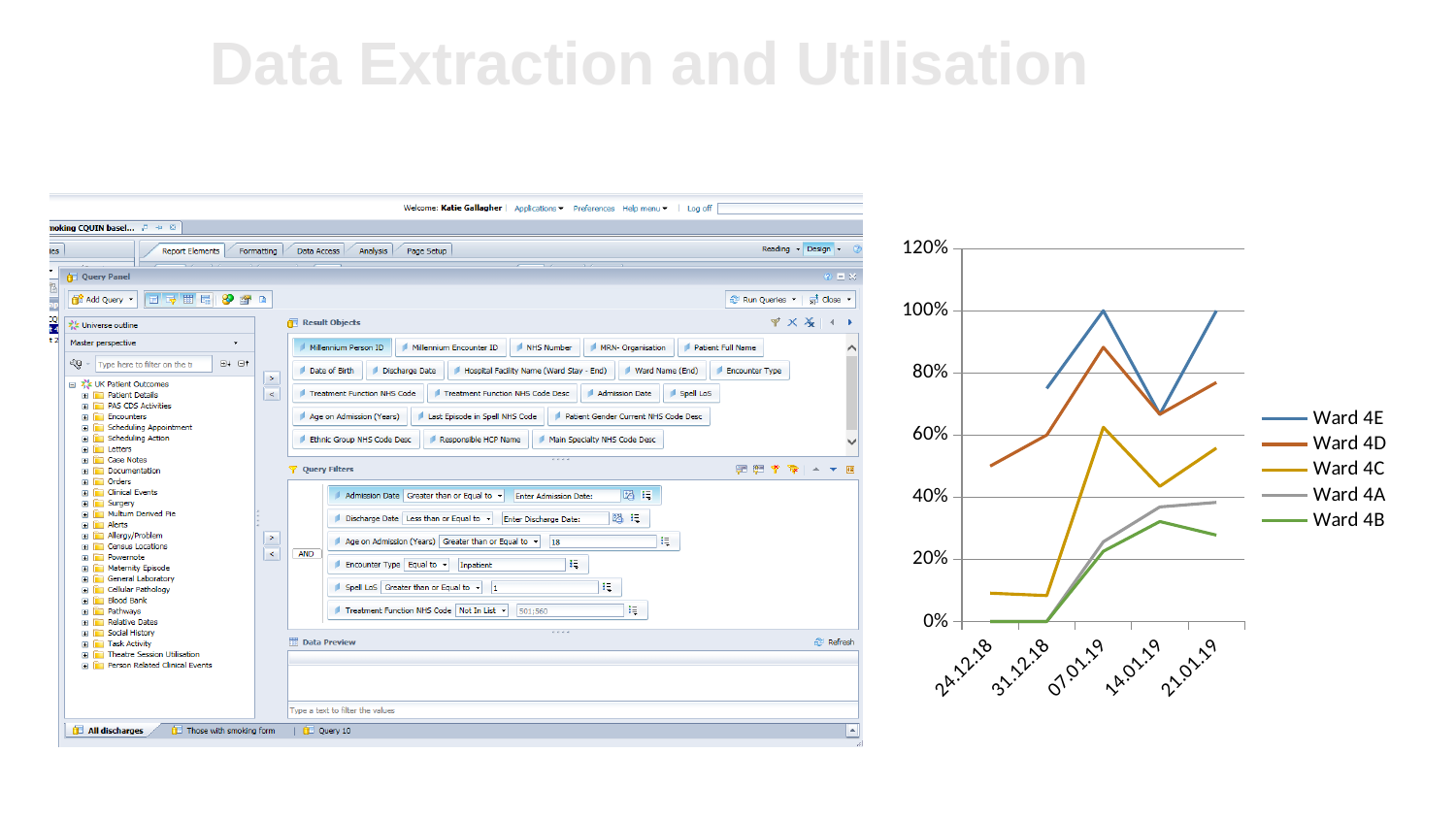
In the line chart, which ward has the lowest value on 21.01.19? Ward 4B In the line chart, what is the value for Ward 4A on 24.12.18? 0% What colour is the line for Ward 4B in the line chart? green How many series does the legend of the line chart list? 5 In the line chart, is the value for Ward 4C on 24.12.18 greater or less than 20%? less In the line chart, what is the value for Ward 4E on 07.01.19? 100% In the line chart, which ward has the highest value on 21.01.19? Ward 4E What kind of chart is shown on the right of the slide? line chart In the line chart, which is larger on 14.01.19: Ward 4D or Ward 4C? Ward 4D In the line chart, does the value for Ward 4C rise or fall between 07.01.19 and 14.01.19? fall In the line chart, is the value for Ward 4D on 07.01.19 greater or less than 80%? greater How many dates are shown on the x axis of the line chart? 5